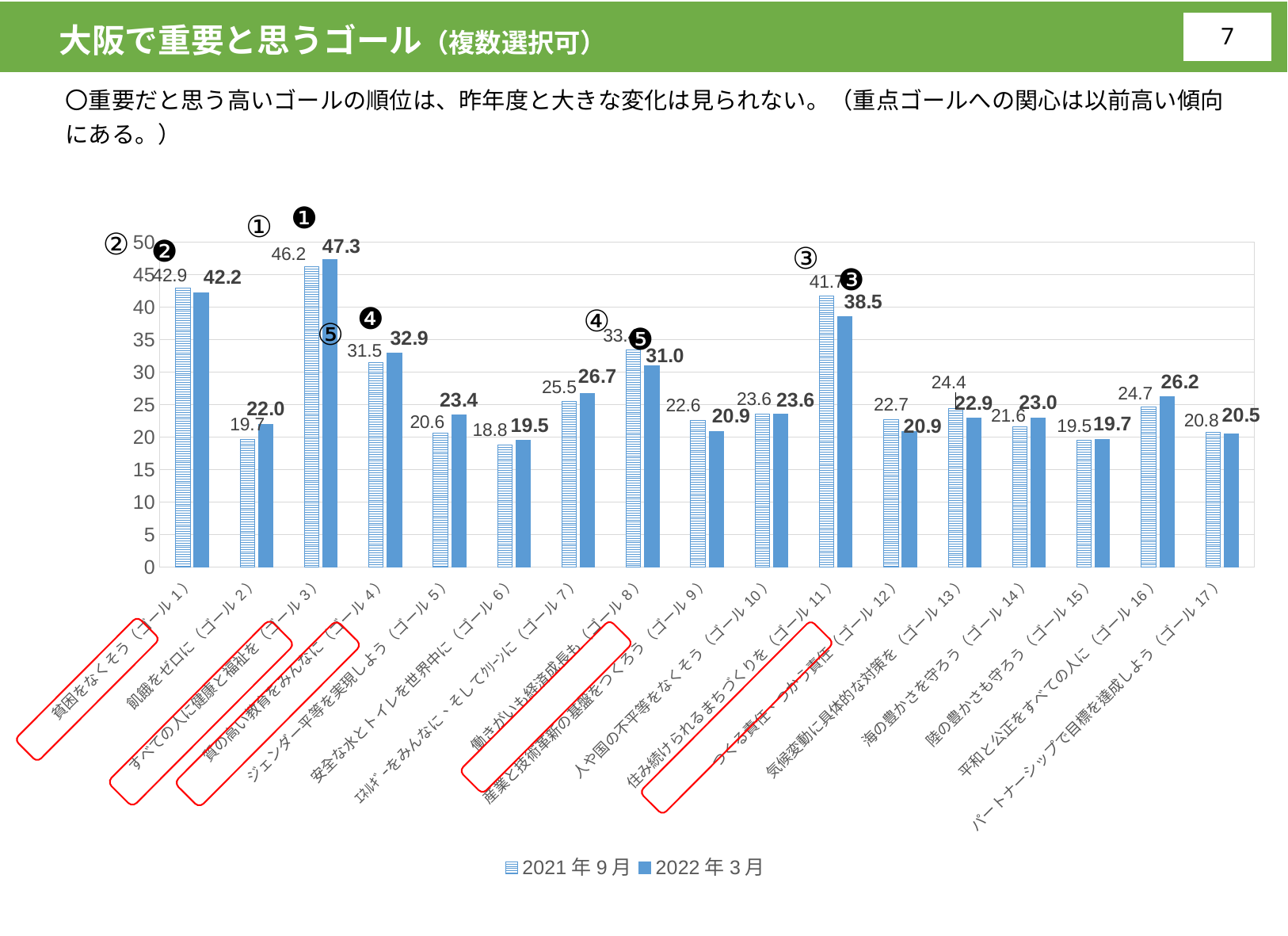
Which goal has the highest 2022年3月 value? ゴール3 For ゴール2, which is larger: the 2021年9月 value or the 2022年3月 value? 2022年3月 Which series is shown with solid blue bars in the legend? 2022年3月 What is the 2021年9月 value for ゴール11 (住み続けられるまちづくりを)? 41.7 Is the 2022年3月 value for ゴール1 greater or less than 40? greater How many series does the legend list? 2 What is the 2022年3月 value for ゴール16 (平和と公正をすべての人に)? 26.2 What is the difference between the 2021年9月 and 2022年3月 values for ゴール11? 3.2 How many goal categories are plotted on the x axis? 17 What type of chart is shown on the slide? bar chart Which goal has the lowest 2021年9月 value? ゴール6